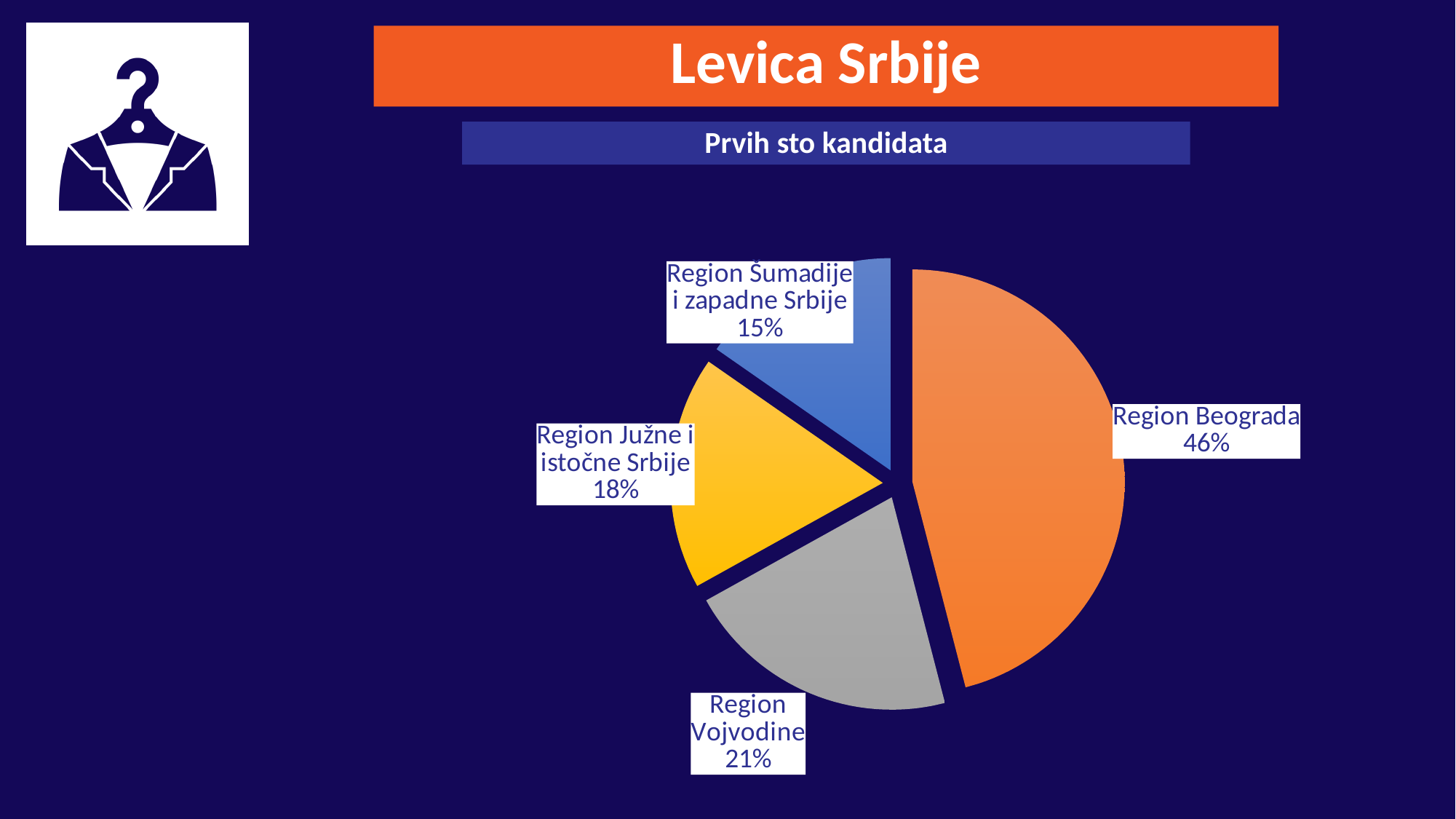
Which region has the smallest slice of the pie? Region Šumadije i zapadne Srbije What is the difference in percentage points between Region Beograda and Region Vojvodine? 25 How many slices does the pie chart have? 4 Which region has the largest slice of the pie? Region Beograda What is the difference in percentage points between Region Južne i istočne Srbije and Region Šumadije i zapadne Srbije? 3 Which is larger, the share for Region Vojvodine or the share for Region Južne i istočne Srbije? Region Vojvodine What share of the pie does Region Beograda have? 46% What kind of chart is shown on the slide? pie chart What share of the pie does Region Vojvodine have? 21% What share of the pie does Region Južne i istočne Srbije have? 18% What is the subtitle shown above the pie chart? Prvih sto kandidata